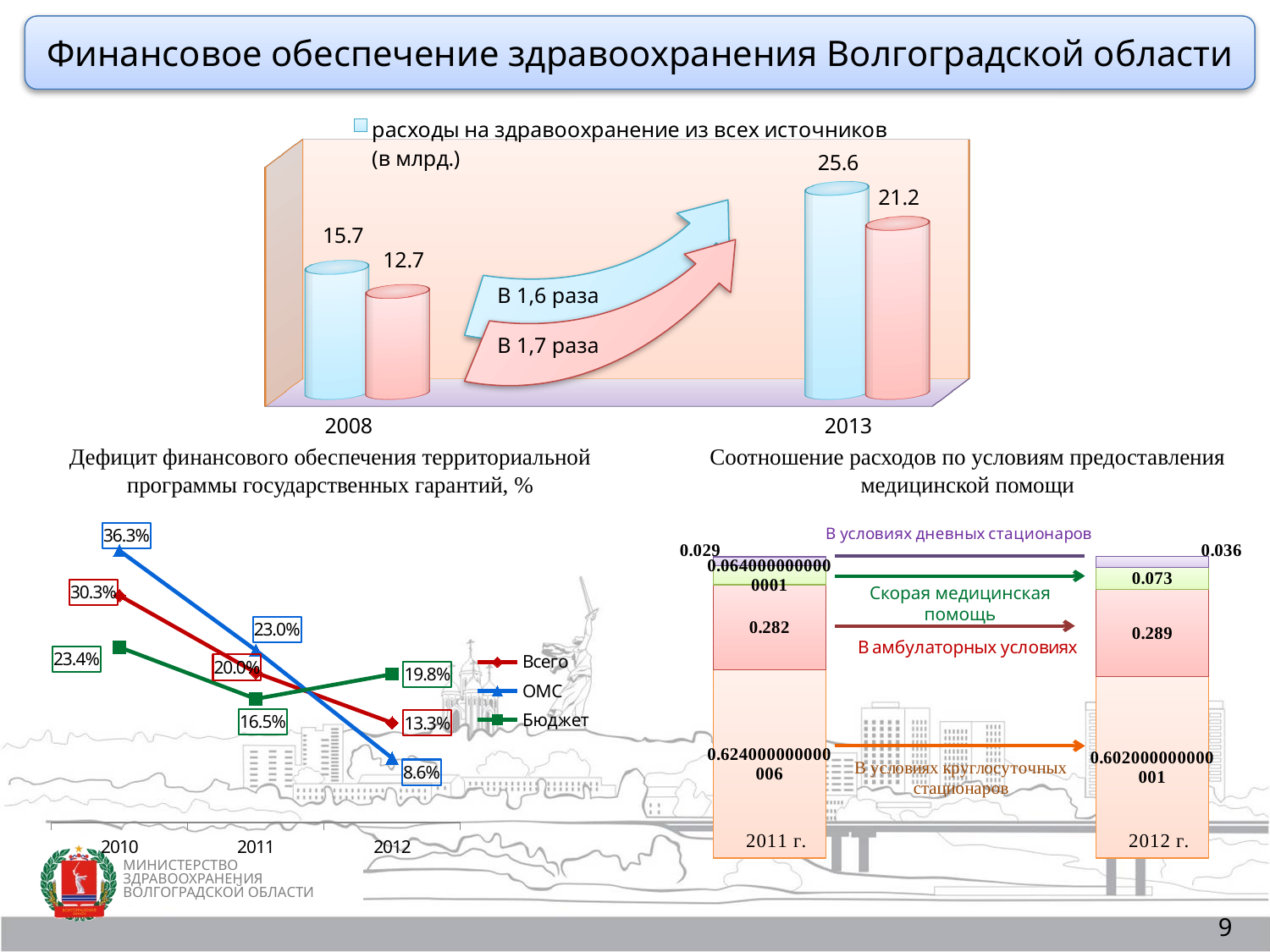
In the chart 'Дефицит финансового обеспечения территориальной программы государственных гарантий, %', what is the difference between Всего in 2010 and Всего in 2012? 17.0% In the top chart, which year has the higher red bar value, 2008 or 2013? 2013 In the chart 'Дефицит финансового обеспечения территориальной программы государственных гарантий, %', what is the value for ОМС in 2012? 8.6% In the chart 'Дефицит финансового обеспечения территориальной программы государственных гарантий, %', does the ОМС series rise or fall from 2010 to 2012? fall In the chart 'Соотношение расходов по условиям предоставления медицинской помощи', what is the value for 'В амбулаторных условиях' in 2012? 0.289 In the chart 'Дефицит финансового обеспечения территориальной программы государственных гарантий, %', how many series does the legend list? 3 In the chart 'Дефицит финансового обеспечения территориальной программы государственных гарантий, %', what is the value for Бюджет in 2011? 16.5% In the top chart, what is the difference between the blue bar values for 2013 and 2008? 9.9 In the top chart, what is the value of the red bar for 2013? 21.2 In the chart 'Дефицит финансового обеспечения территориальной программы государственных гарантий, %', which series has the highest value in 2010? ОМС In the chart 'Соотношение расходов по условиям предоставления медицинской помощи', what is the value for 'В условиях дневных стационаров' in 2011? 0.029 In the top chart, what is the value of the blue bar for 2008? 15.7